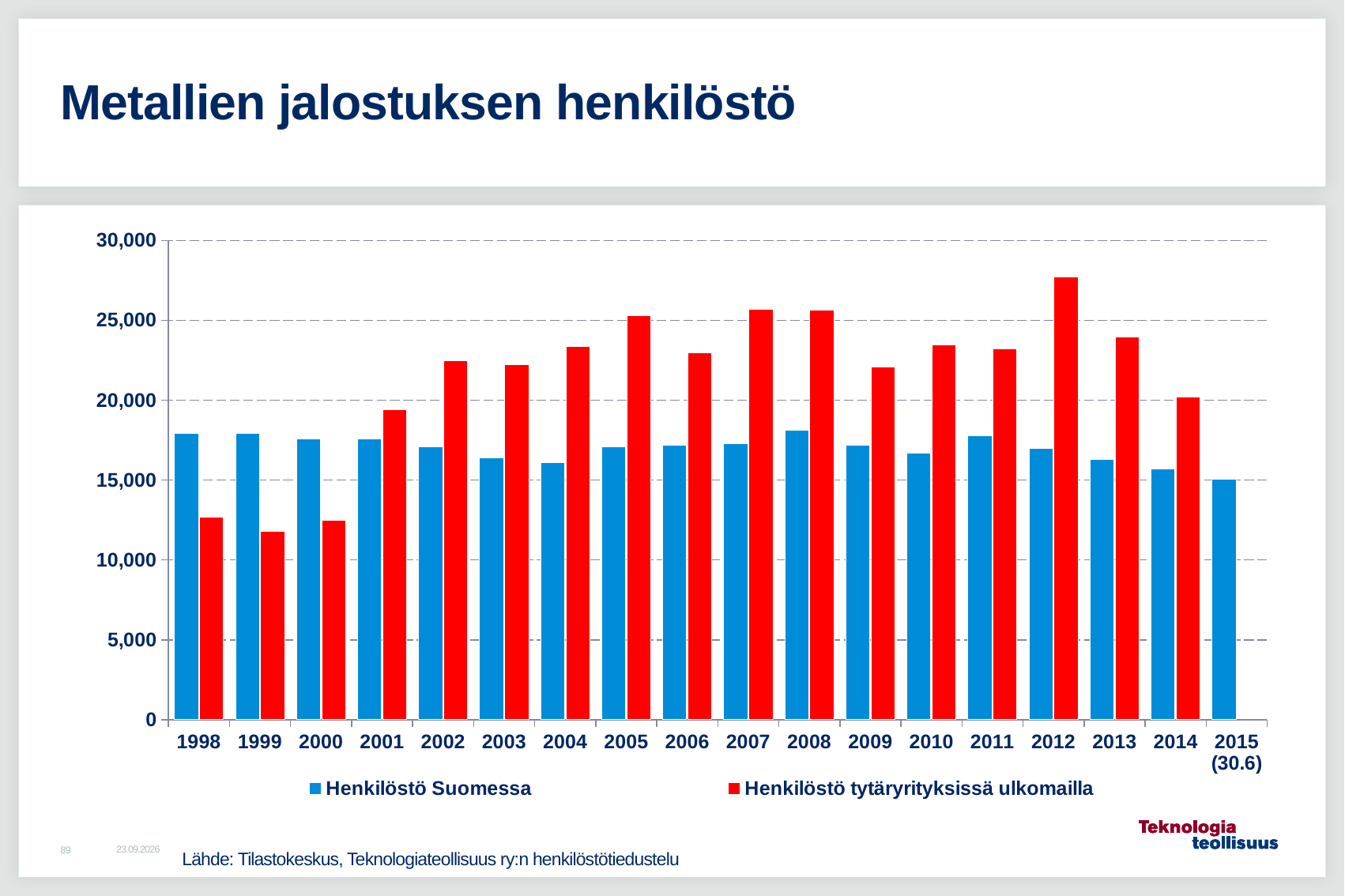
What kind of chart is shown on the slide? bar chart In 2012, which series has the larger value: Henkilöstö Suomessa or Henkilöstö tytäryrityksissä ulkomailla? Henkilöstö tytäryrityksissä ulkomailla What is the title of the chart on the slide? Metallien jalostuksen henkilöstö Is the value for Henkilöstö tytäryrityksissä ulkomailla in 1999 greater or less than 15,000? less In which year is the value for Henkilöstö tytäryrityksissä ulkomailla lowest? 1999 In which year is the value for Henkilöstö Suomessa lowest? 2015 (30.6) Is the value for Henkilöstö tytäryrityksissä ulkomailla in 2012 greater or less than 25,000? greater How many years (categories) are shown on the x axis? 18 In which year is the value for Henkilöstö tytäryrityksissä ulkomailla highest? 2012 In 1998, which series has the larger value: Henkilöstö Suomessa or Henkilöstö tytäryrityksissä ulkomailla? Henkilöstö Suomessa Is the value for Henkilöstö Suomessa in 2003 greater or less than 15,000? greater How many series does the legend list? 2